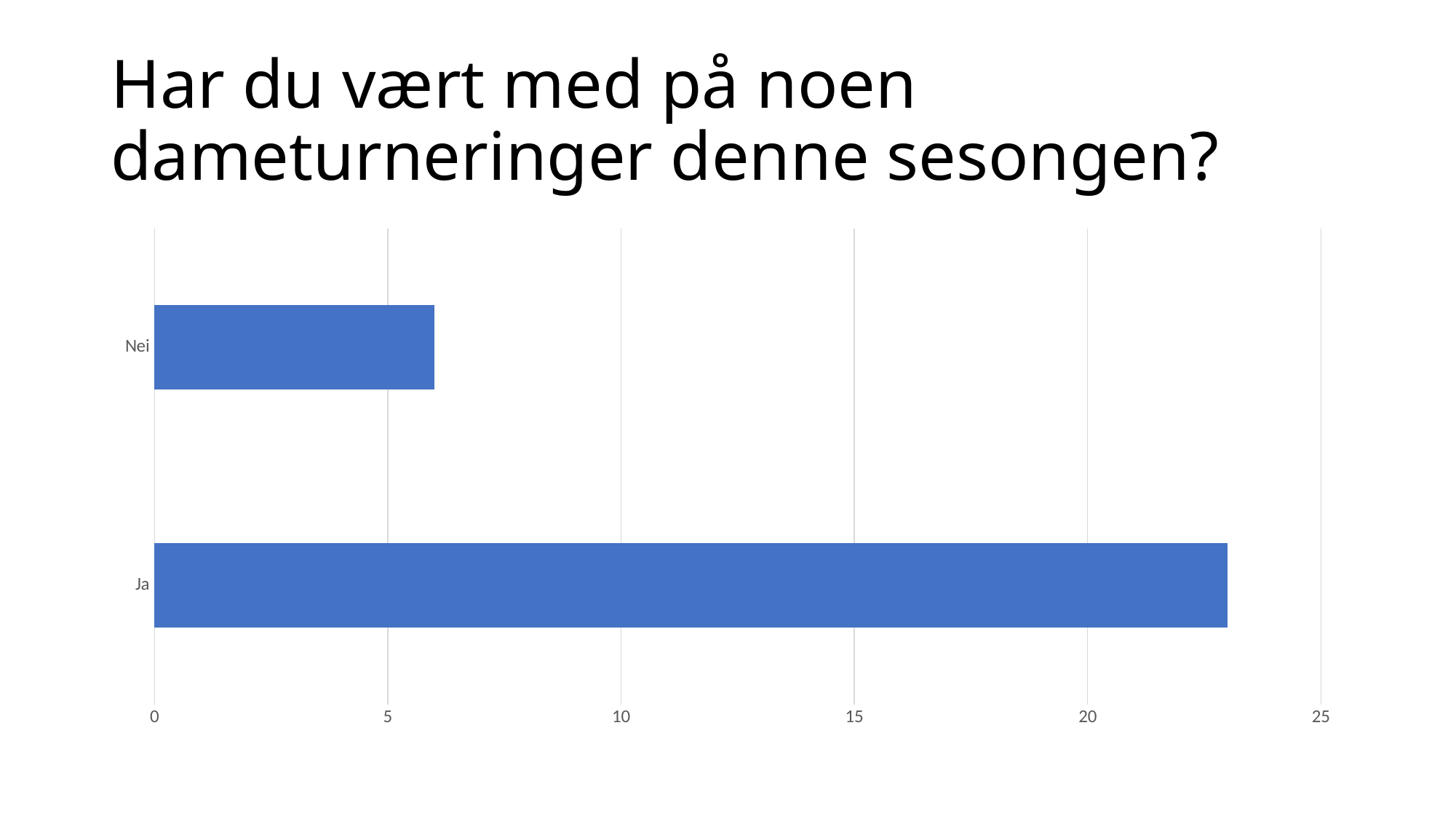
Which is larger, the value for Ja or the value for Nei? Ja What is the highest value shown on the horizontal axis? 25 Which category has the lowest value? Nei Which category has the highest value? Ja Is the value for Nei greater or less than 10? less Is the value for Ja greater or less than 25? less Is the value for Nei greater or less than 5? greater What kind of chart is shown on the slide? bar chart What is the title of the slide? Har du vært med på noen dameturneringer denne sesongen? What colour are the bars in the chart? blue How many categories are shown in the chart? 2